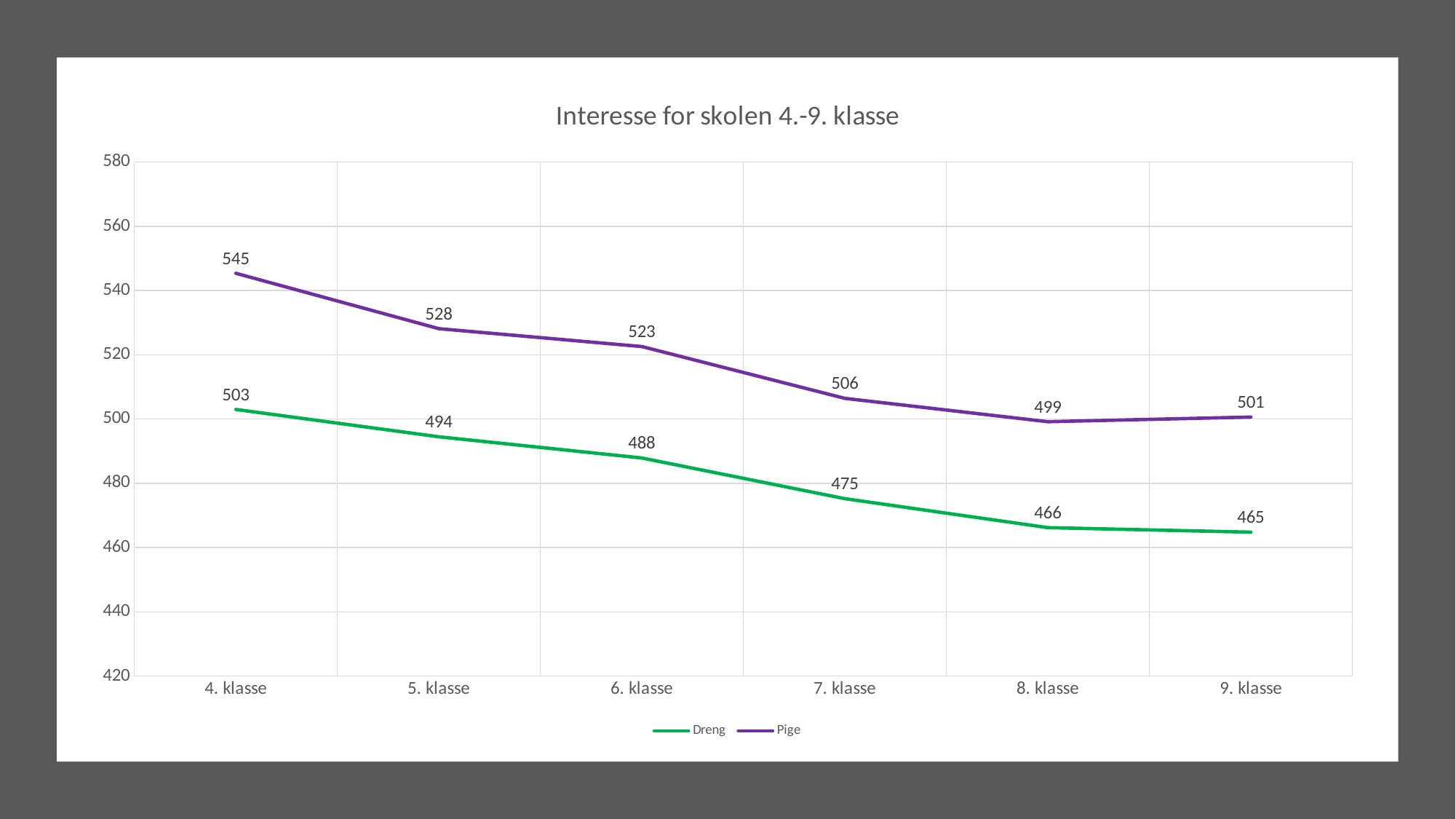
How many series does the legend list? 2 Does the Dreng series rise or fall from 4. klasse to 9. klasse? Fall What is the value for Pige in 4. klasse? 545 What is the value for Pige in 8. klasse? 499 What kind of chart is this? Line chart What is the title of the chart? Interesse for skolen 4.-9. klasse Which is larger in 5. klasse, the Dreng value or the Pige value? Pige In which klasse is the Dreng value lowest? 9. klasse In which klasse is the Pige value highest? 4. klasse How many klasse categories are shown on the x axis? 6 What is the value for Dreng in 7. klasse? 475 What is the difference between the Pige and Dreng values in 6. klasse? 35